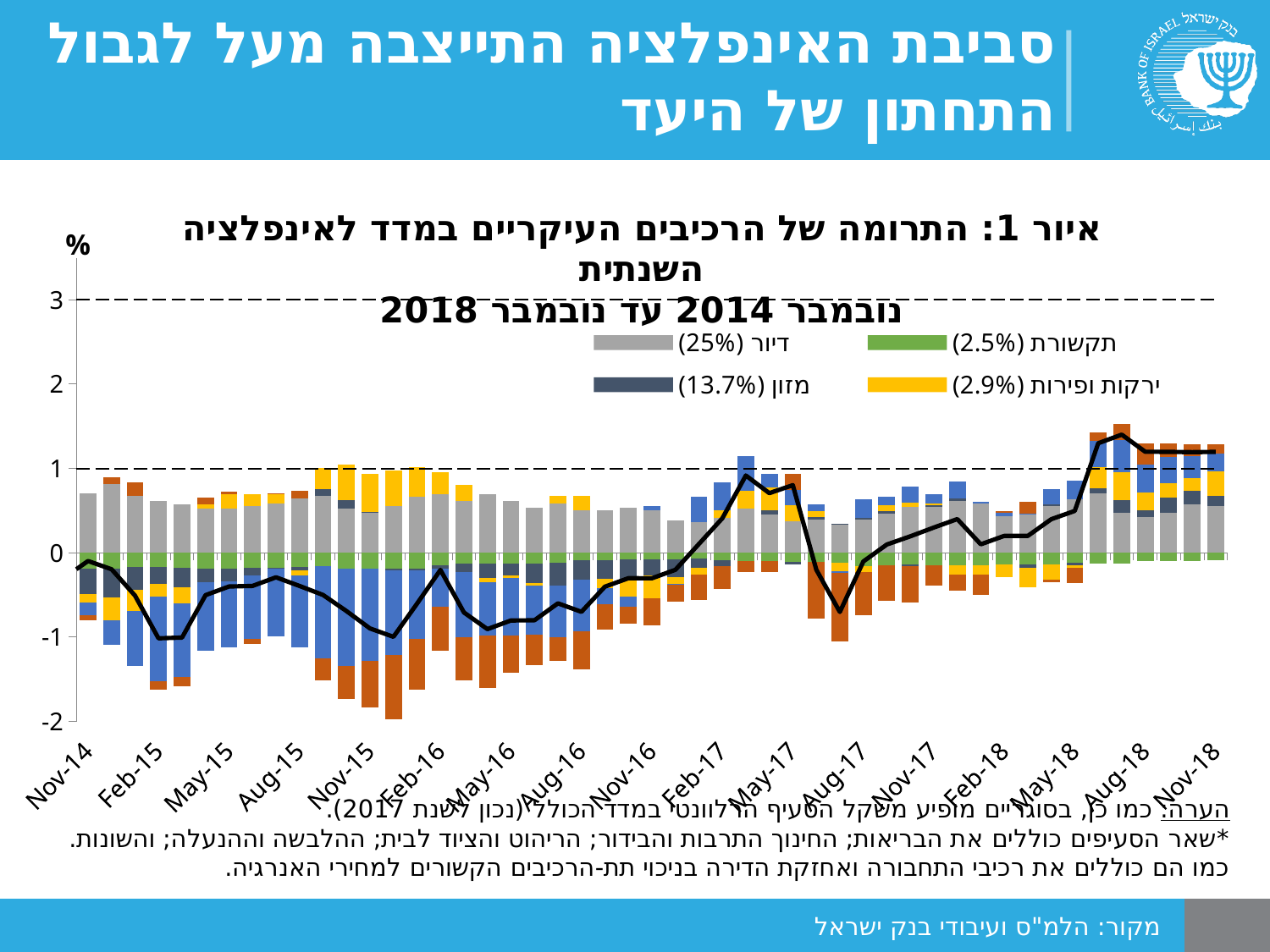
Is the value of the black line at Nov-18 greater or less than 1? greater Is the value of the black line at May-16 greater or less than 0? less Which colour represents דיור (25%) in the legend? Gray Is the value of the black line at Aug-18 greater or less than 1? greater How many series does the chart's legend list? 4 Is the black line higher at Nov-18 or at Nov-14? Nov-18 What is the title of the chart? איור 1: התרומה של הרכיבים העיקריים במדד לאינפלציה השנתית נובמבר 2014 עד נובמבר 2018 Does the black line rise or fall between Aug-17 and Aug-18? Rises How many date labels are shown on the x axis? 17 What kind of chart is shown on the slide? Stacked bar chart with a line